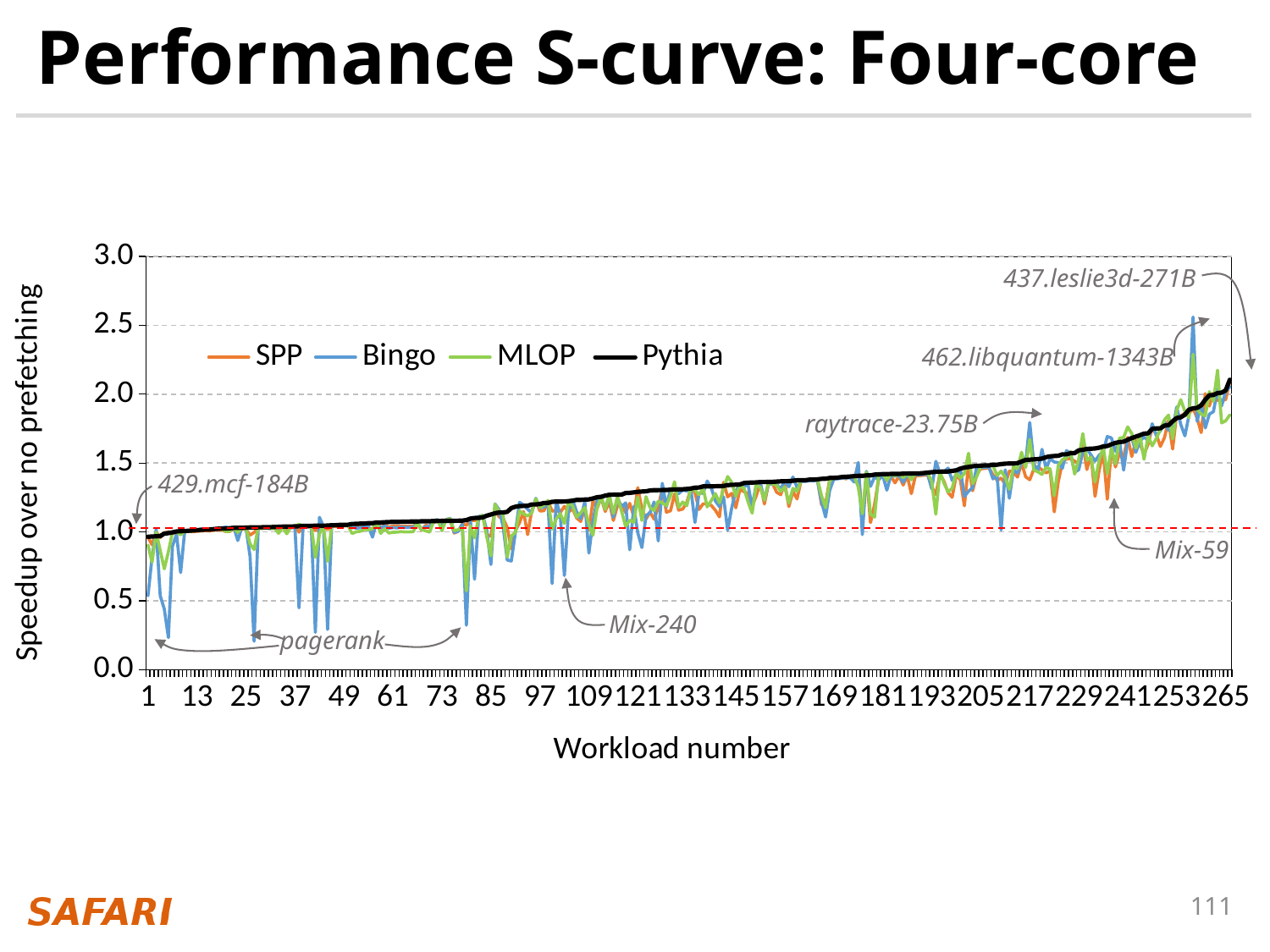
Is the Pythia value at workload number 1 greater or less than 1.5? less How many series does the legend list? 4 What is the highest value shown on the y axis? 3.0 Does the Pythia line rise or fall as the workload number increases? rise What is the label of the x axis? Workload number What is the label of the y axis? Speedup over no prefetching Is the Pythia value at workload number 265 greater or less than 1.5? greater What kind of chart is shown on the slide? line chart Is the highest Bingo value on the chart greater or less than 2.0? greater